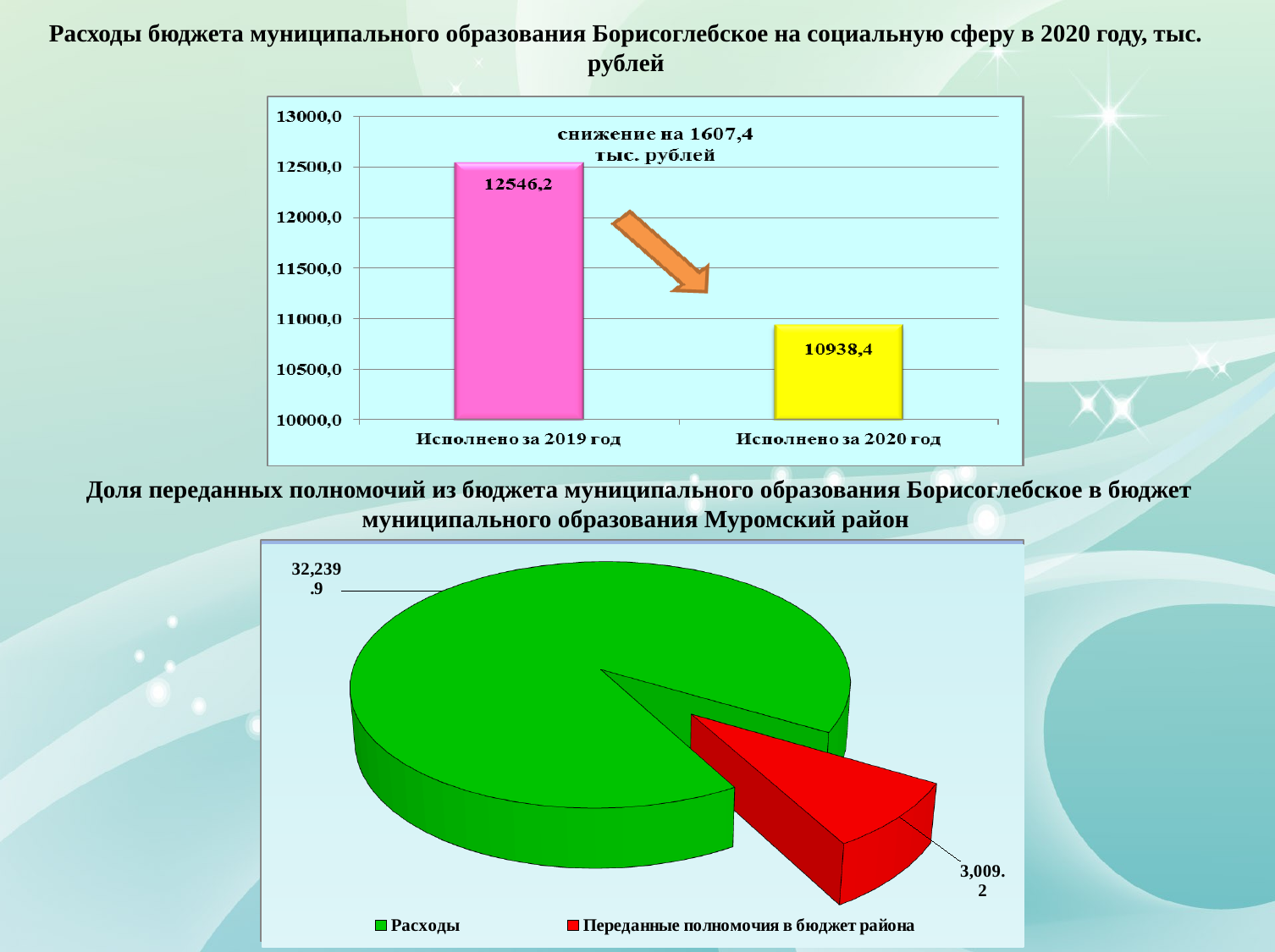
In the bottom pie chart, what is the value for 'Расходы'? 32,239.9 In the bottom pie chart, what is the value for 'Переданные полномочия в бюджет района'? 3,009.2 What kind of chart is the bottom chart, 'Доля переданных полномочий из бюджета муниципального образования Борисоглебское в бюджет муниципального образования Муромский район'? pie chart In the top bar chart, which category has the higher value? Исполнено за 2019 год In the top bar chart, do the values rise or fall from 2019 to 2020? fall In the bottom pie chart, which slice is larger: 'Расходы' or 'Переданные полномочия в бюджет района'? Расходы What kind of chart is the top chart, 'Расходы бюджета муниципального образования Борисоглебское на социальную сферу в 2020 году'? bar chart In the top bar chart, is the value for 'Исполнено за 2020 год' greater or less than 11000,0? less How many bars are shown in the top bar chart? 2 In the top bar chart, what is the value for 'Исполнено за 2020 год'? 10938,4 In the top bar chart, what is the value for 'Исполнено за 2019 год'? 12546,2 In the top bar chart, what does the annotation next to the arrow say? снижение на 1607,4 тыс. рублей